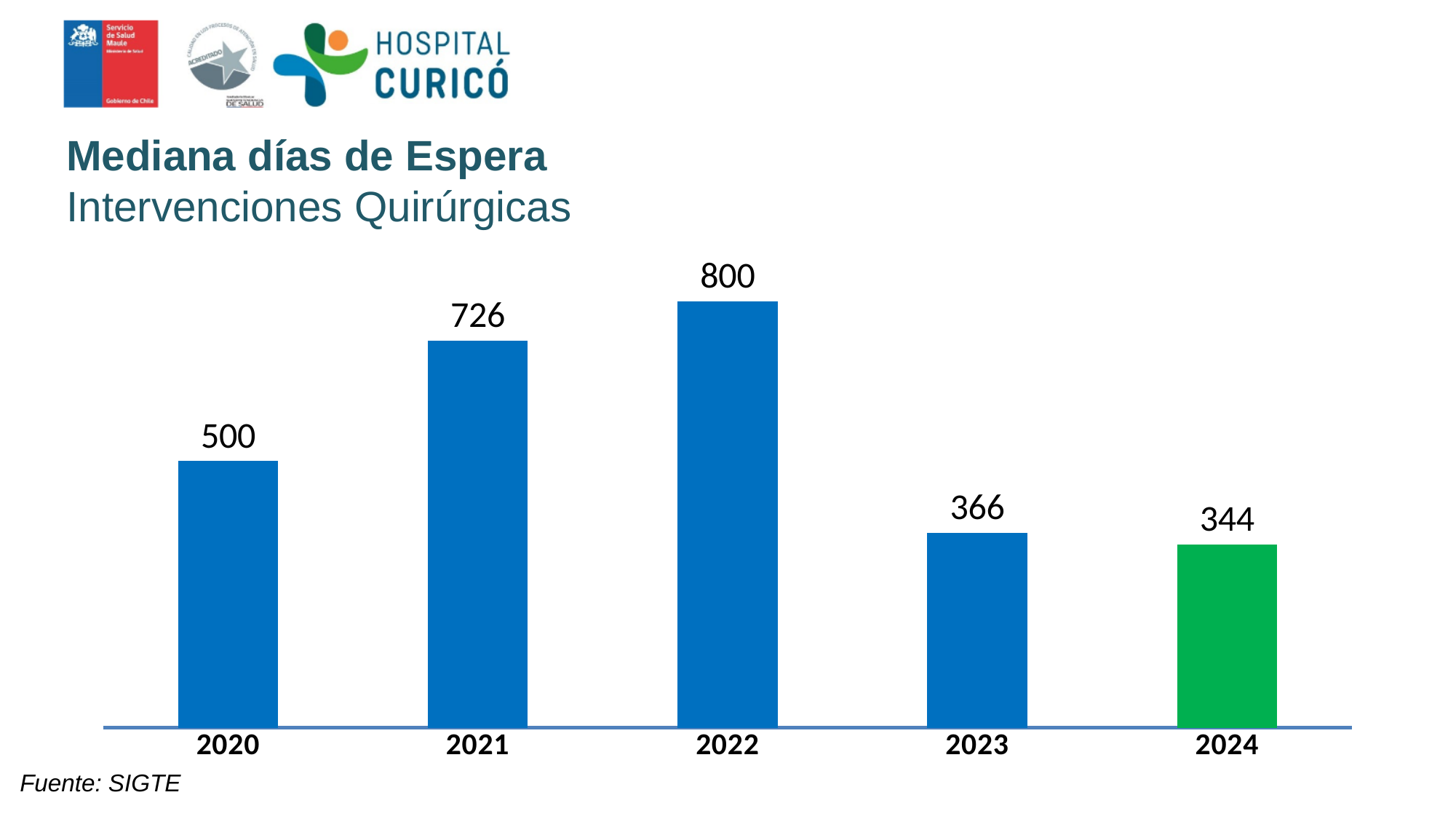
What is the value shown for 2022? 800 How many years are shown on the chart? 5 Which year has a larger value, 2021 or 2023? 2021 What is the difference between the values for 2022 and 2023? 434 Which year has the highest median waiting days? 2022 Do the values rise or fall from 2022 to 2024? Fall What kind of chart is shown on the slide? Bar chart What is the value shown for 2024? 344 What is the difference between the values for 2021 and 2020? 226 Which year's bar is coloured green instead of blue? 2024 What is the median waiting days value for 2020? 500 Which year has the lowest median waiting days? 2024